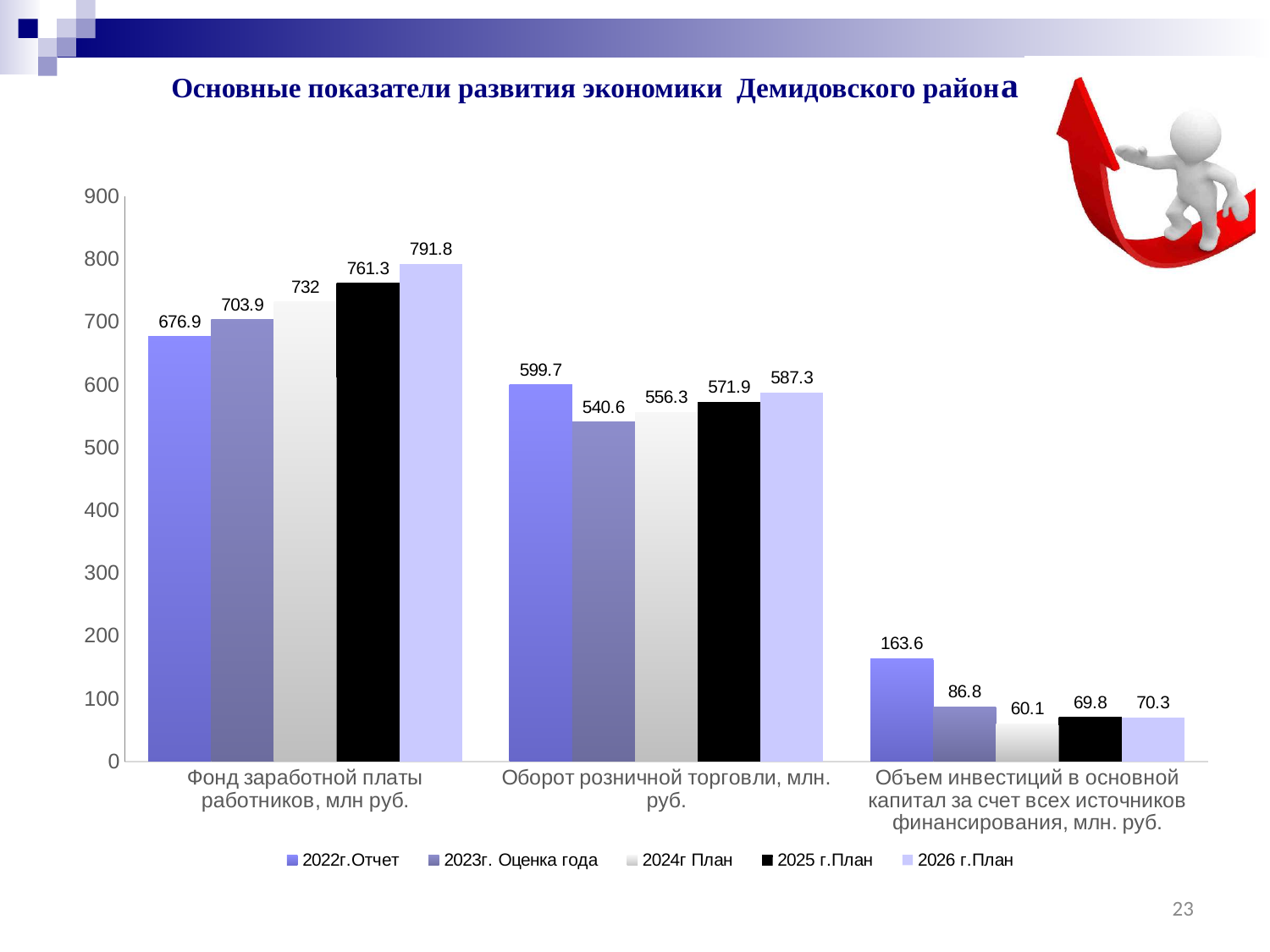
What is the difference between the 2026 г.План and 2022г.Отчет values for "Фонд заработной платы работников, млн руб."? 114.9 Is the 2025 г.План value for "Оборот розничной торговли, млн. руб." greater or less than 600? less What is the value for 2022г.Отчет in the category "Фонд заработной платы работников, млн руб."? 676.9 What is the value for 2023г. Оценка года in the category "Объем инвестиций в основной капитал за счет всех источников финансирования, млн. руб."? 86.8 Which series has the lowest value in the category "Объем инвестиций в основной капитал за счет всех источников финансирования, млн. руб."? 2024г План Which series has the highest value in the category "Фонд заработной платы работников, млн руб."? 2026 г.План Which is larger for "Оборот розничной торговли, млн. руб.": the 2022г.Отчет value or the 2023г. Оценка года value? 2022г.Отчет What kind of chart is shown on the slide? bar chart How many categories are shown on the x axis? 3 Do the values for "Фонд заработной платы работников, млн руб." rise or fall from 2022г.Отчет to 2026 г.План? rise How many series does the legend list? 5 What is the value for 2024г План in the category "Оборот розничной торговли, млн. руб."? 556.3